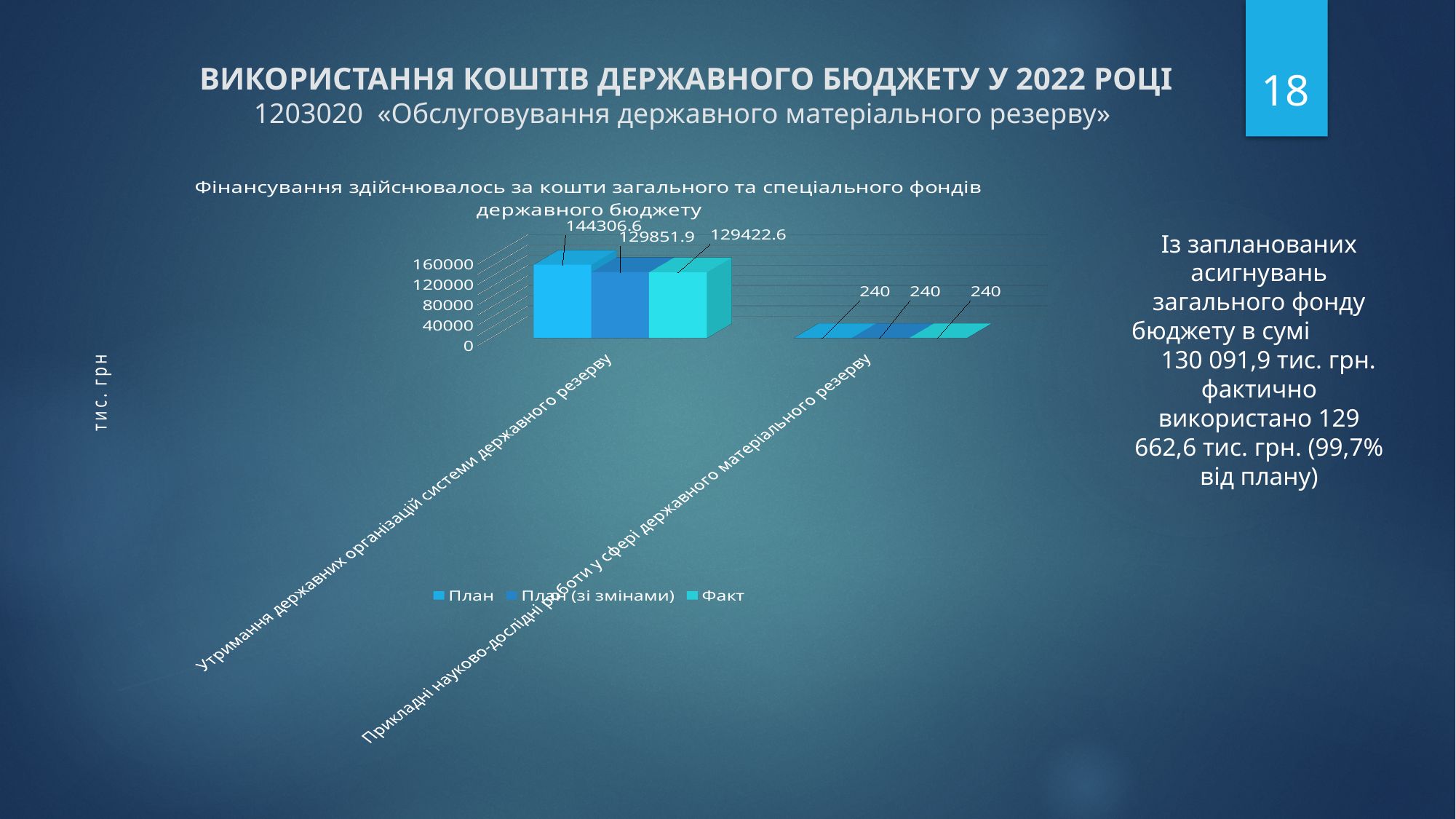
Which is larger for Утримання державних організацій системи державного резерву: План (зі змінами) or Факт? План (зі змінами) What is the value of Факт for Прикладні науково-дослідні роботи у сфері державного матеріального резерву? 240 Which series has the highest value for Утримання державних організацій системи державного резерву? План What is the value of План for Утримання державних організацій системи державного резерву? 144306.6 What is the difference between План and Факт for Утримання державних організацій системи державного резерву? 14884 What is the value of Факт for Утримання державних організацій системи державного резерву? 129422.6 Is the План value for Утримання державних організацій системи державного резерву greater or less than 120000? greater Which category has the lowest Факт value? Прикладні науково-дослідні роботи у сфері державного матеріального резерву How many series does the chart legend list? 3 What is the value of План (зі змінами) for Утримання державних організацій системи державного резерву? 129851.9 What kind of chart is shown on the slide? bar chart How many categories are shown on the x axis of the chart? 2